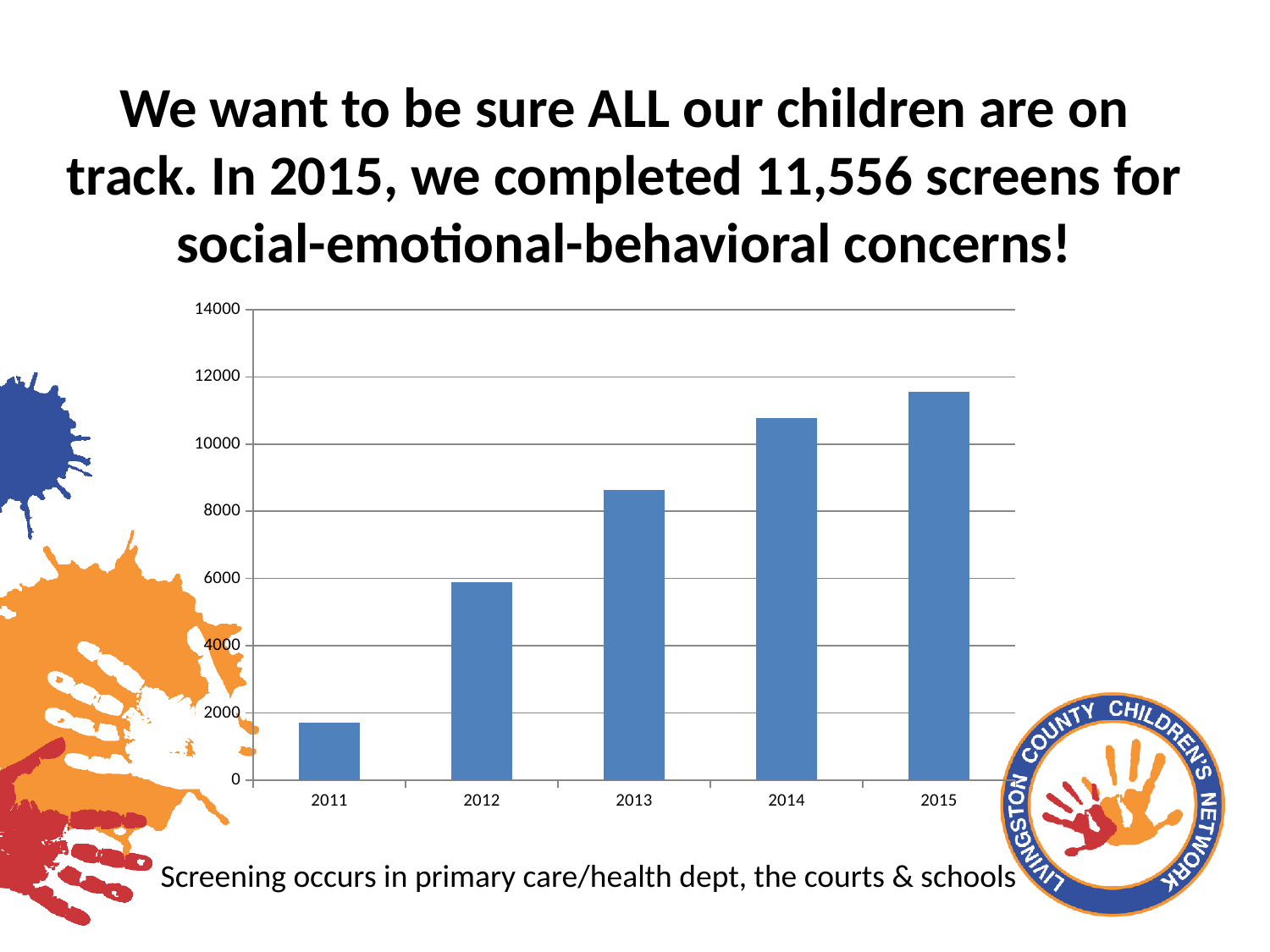
What kind of chart is shown on the slide? bar chart What is the highest value shown on the chart's vertical axis? 14000 Is the value for 2011 greater or less than 2000? less Which year has a larger value, 2012 or 2014? 2014 Is the value for 2014 greater or less than 10000? greater Which year has the highest bar in the chart? 2015 How many years are shown on the x axis of the chart? 5 According to the slide, how many screens were completed in 2015? 11,556 Do the values rise or fall from 2011 to 2015? rise Is the value for 2013 greater or less than 8000? greater Which year has the lowest bar in the chart? 2011